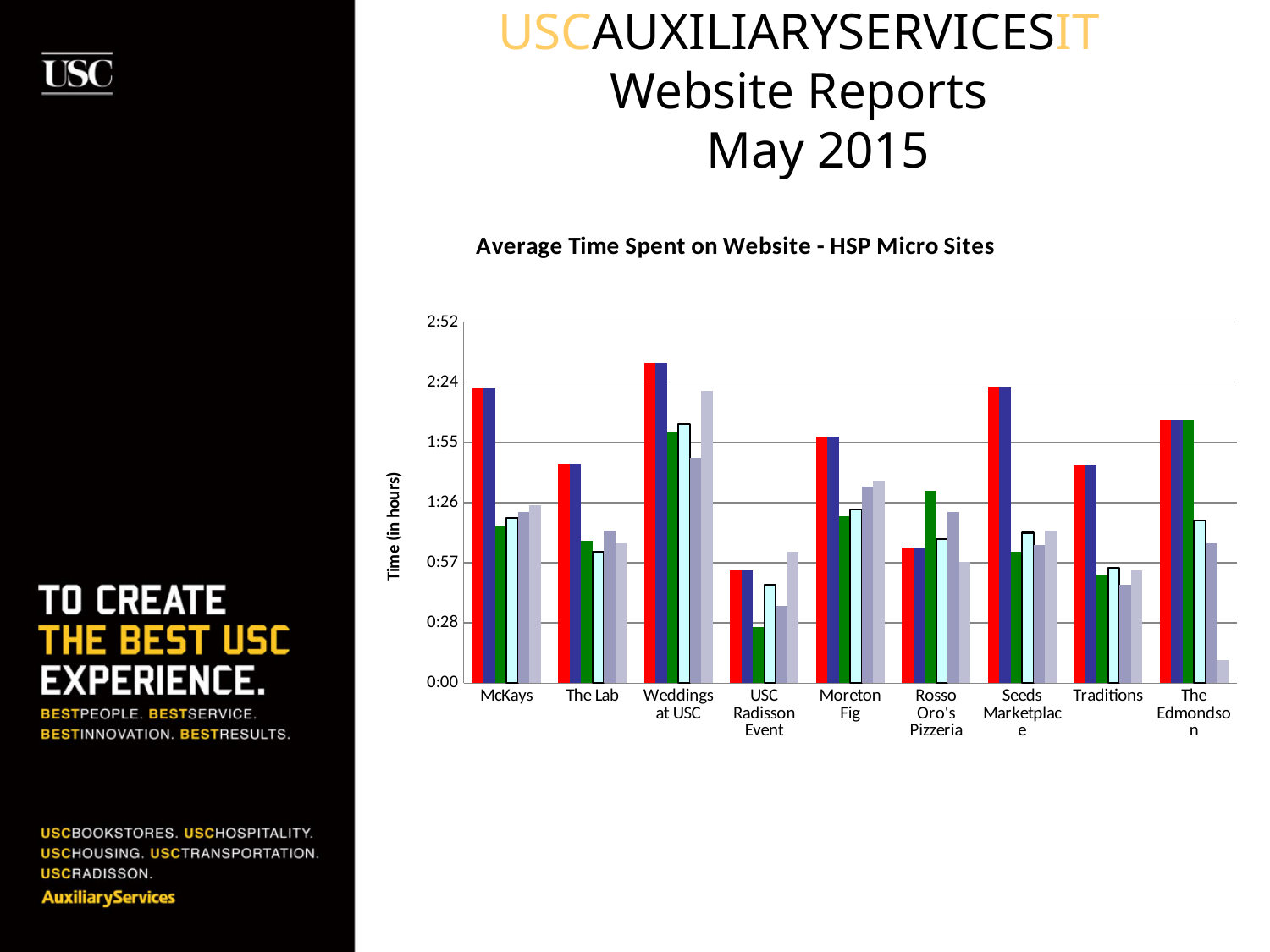
What is the title of the chart? Average Time Spent on Website - HSP Micro Sites Which website has the tallest red bar? Weddings at USC Is the red bar for Weddings at USC greater or less than 2:24? greater Which has the taller red bar, McKays or The Lab? McKays How many bars are plotted for each website category? 6 Which has the taller green bar, Rosso Oro's Pizzeria or Seeds Marketplace? Rosso Oro's Pizzeria How many website categories are shown along the x axis? 9 What is the label on the vertical axis of the chart? Time (in hours) Which website has the shortest red bar? USC Radisson Event What kind of chart is shown on the slide? bar chart Is the red bar for McKays greater or less than 1:55? greater Is the last (rightmost) bar for The Edmondson greater or less than 0:28? less